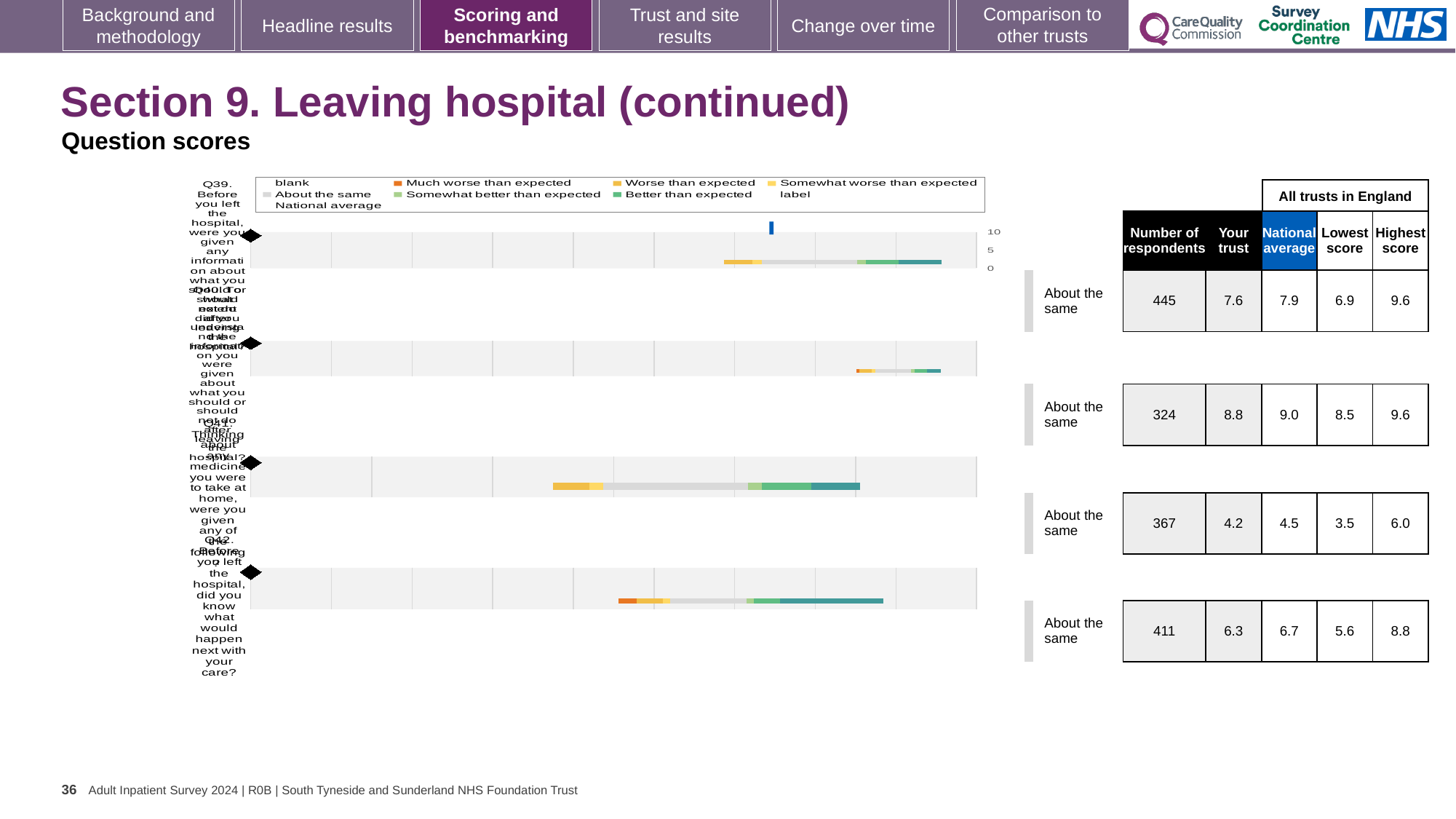
In the table beside the chart, what is the number of respondents for the first row (Q39)? 445 Which legend entry is shown in dark teal? Better than expected In the table beside the chart, what is the difference between the highest and lowest score for the third row? 2.5 Which colour does the legend use for 'Much worse than expected'? orange In the table beside the chart, what is the 'Your trust' score for the first row (Q39)? 7.6 In the table beside the chart, what is the highest score for the last row (Q42)? 8.8 In the table beside the chart, what is the national average for the third row? 4.5 In the table beside the chart, which row has the lowest 'Your trust' score? the third row (4.2) What kind of chart is shown on the slide? bar chart In the table beside the chart, is the 'Your trust' score for the second row larger or smaller than the national average for that row? smaller In the table beside the chart, what is the difference between the national average and the 'Your trust' score for the first row (Q39)? 0.3 How many horizontal bars does the chart contain? 4